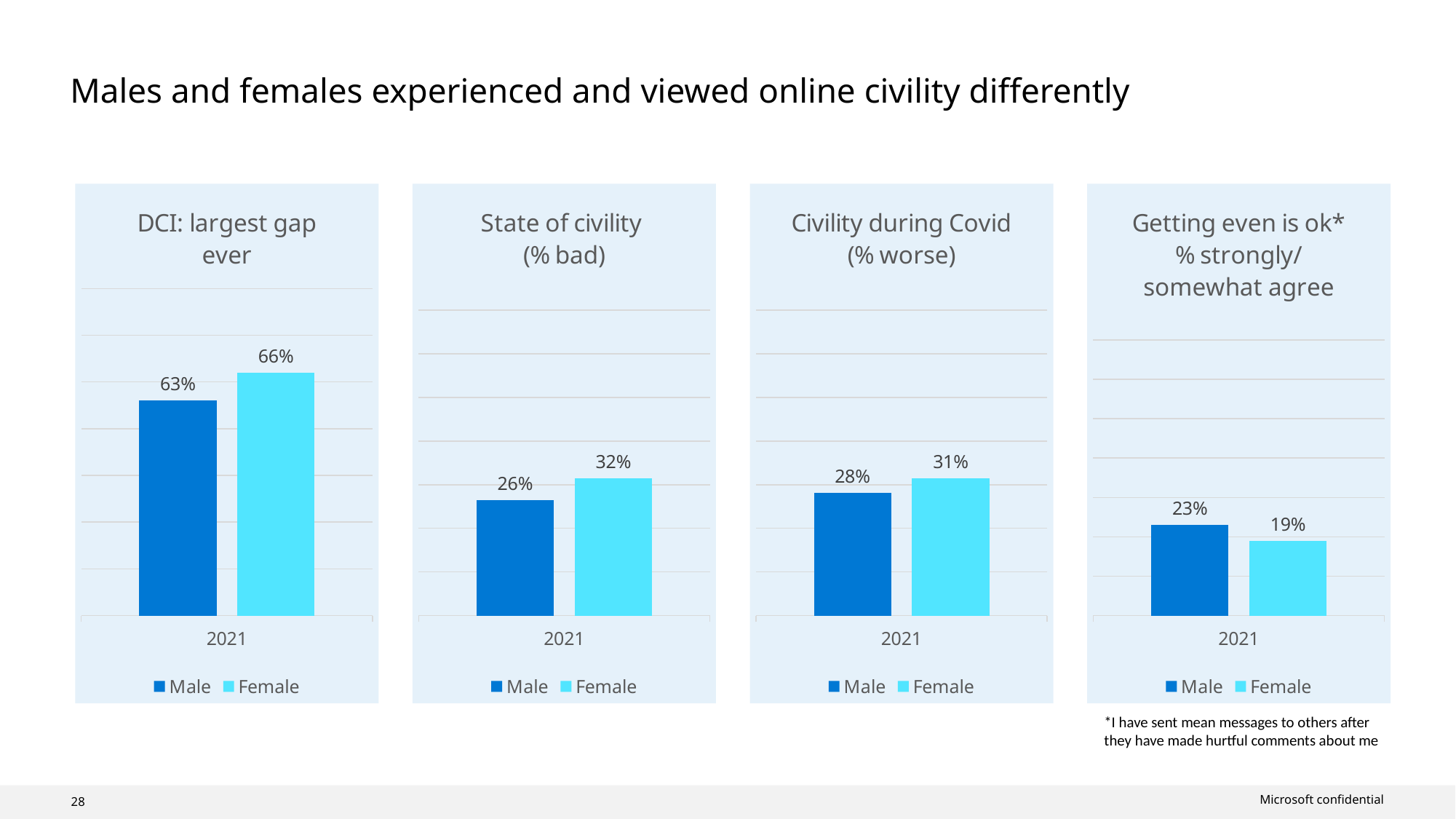
In the 'State of civility (% bad)' chart, what is the difference between the Female and Male values? 6% What kind of chart is the 'Civility during Covid (% worse)' chart? Bar chart In the 'DCI: largest gap ever' chart, which colour represents the Female series? Light blue In the 'DCI: largest gap ever' chart, what is the value for Male in 2021? 63% In the 'Civility during Covid (% worse)' chart, which series has the higher value, Male or Female? Female How many series does the legend list in the 'State of civility (% bad)' chart? 2 In the 'Getting even is ok*' chart, which series has the higher value, Male or Female? Male In the 'State of civility (% bad)' chart, what is the value for Female? 32% In the 'Getting even is ok*' chart, what is the value for Female? 19% In the 'DCI: largest gap ever' chart, what is the value for Female in 2021? 66% In the 'Civility during Covid (% worse)' chart, what is the value for Male? 28% In the 'Getting even is ok*' chart, what is the difference between the Male and Female values? 4%